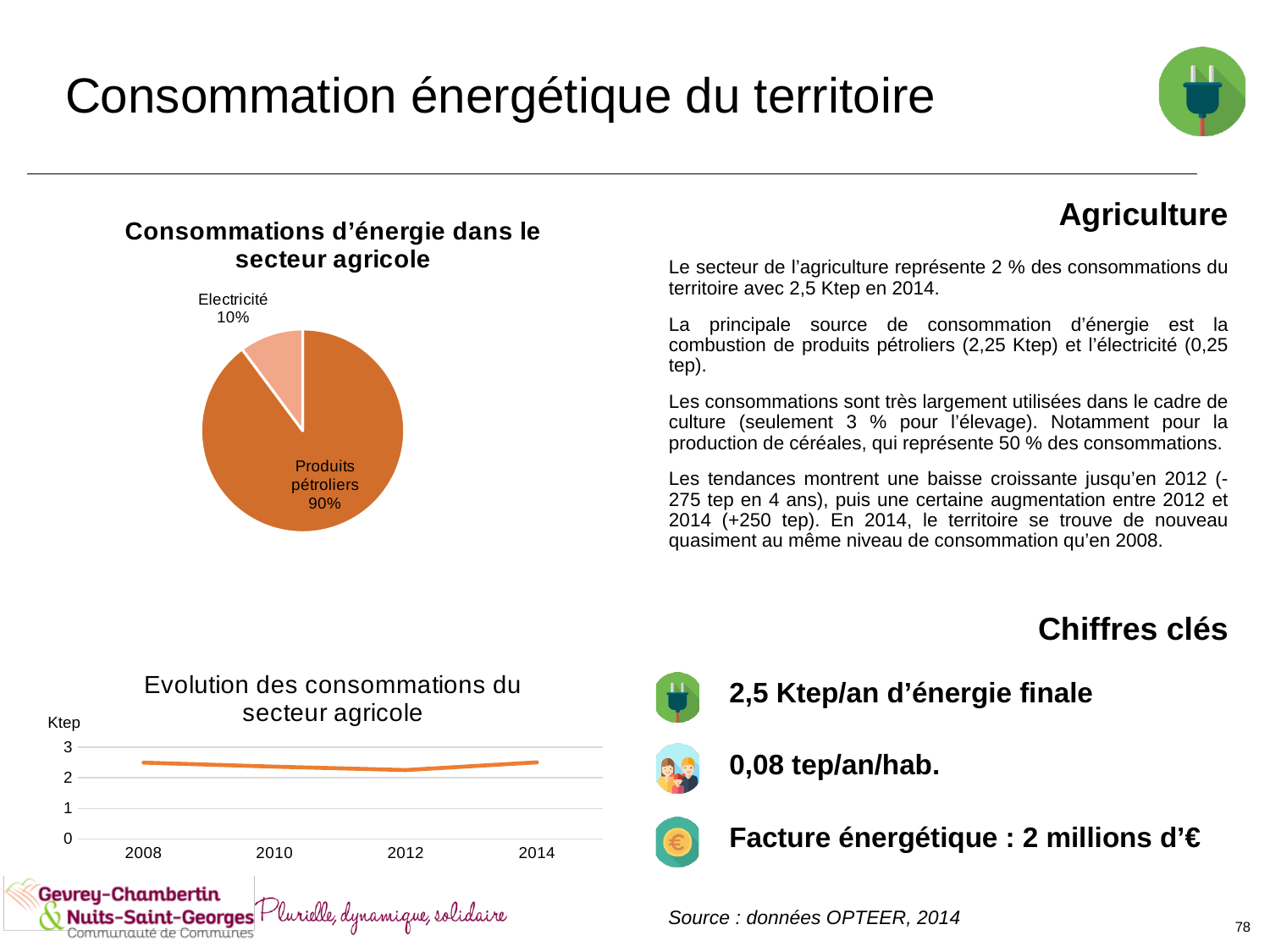
In the chart 'Consommations d'énergie dans le secteur agricole', what is the difference in percentage points between Produits pétroliers and Electricité? 80 In the chart 'Consommations d'énergie dans le secteur agricole', what share of consumption is Produits pétroliers? 90% How many years are labelled on the x axis of the chart 'Evolution des consommations du secteur agricole'? 4 In the chart 'Evolution des consommations du secteur agricole', is the value for 2008 greater or less than 2? greater In the chart 'Consommations d'énergie dans le secteur agricole', which category has the largest share? Produits pétroliers What unit is shown on the y axis of the chart 'Evolution des consommations du secteur agricole'? Ktep In the chart 'Consommations d'énergie dans le secteur agricole', which category has the smallest share? Electricité In the chart 'Evolution des consommations du secteur agricole', is the value for 2012 greater or less than 3? less What kind of chart is 'Evolution des consommations du secteur agricole'? Line chart How many slices does the pie chart 'Consommations d'énergie dans le secteur agricole' have? 2 What kind of chart is 'Consommations d'énergie dans le secteur agricole'? Pie chart In the chart 'Consommations d'énergie dans le secteur agricole', what share of consumption is Electricité? 10%